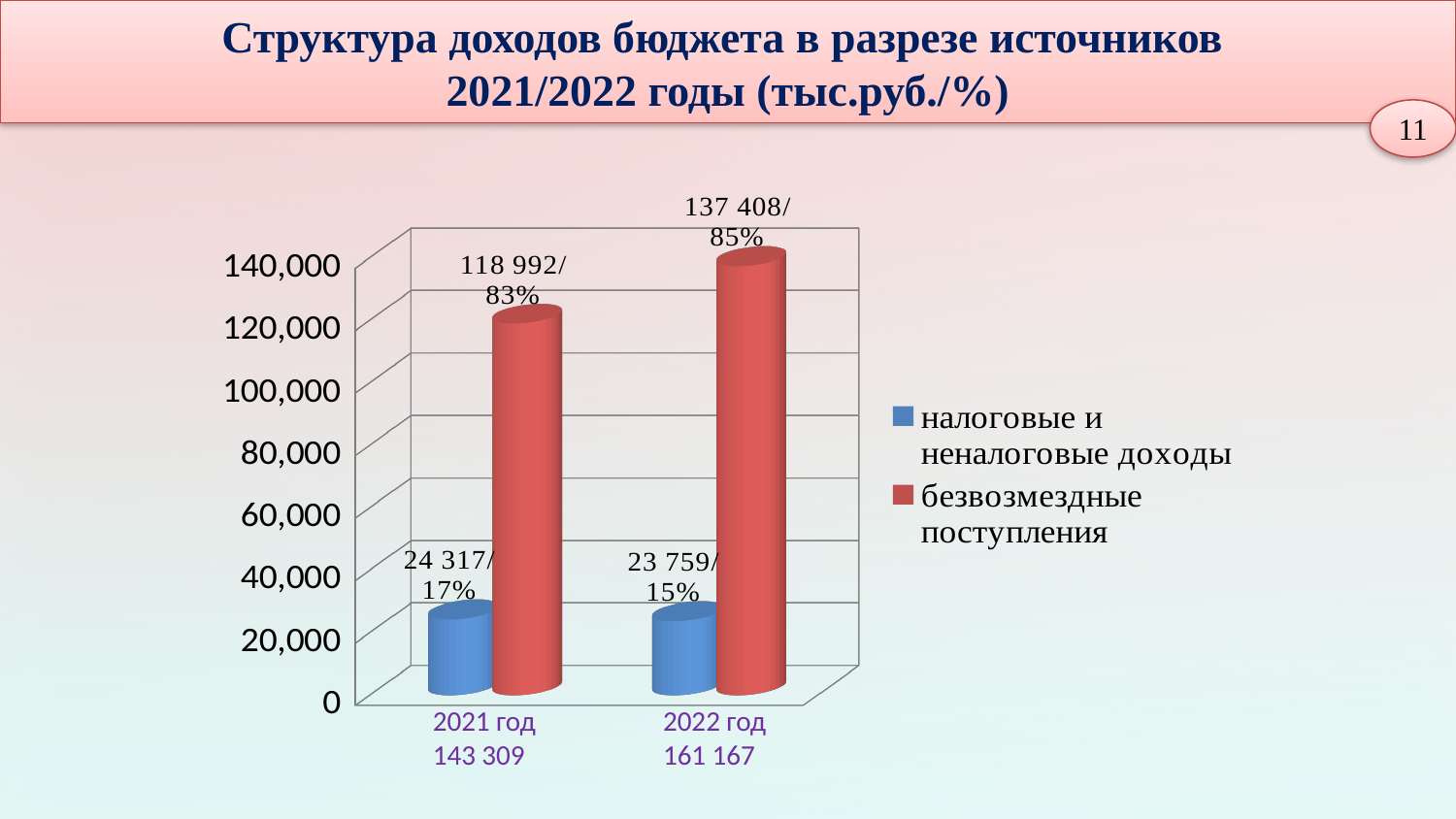
Which bar on the chart is the tallest? безвозмездные поступления, 2022 год What value is labelled on the bar for безвозмездные поступления in 2022 год? 137 408/ 85% What total is printed under the 2022 год category label? 161 167 Which is larger: безвозмездные поступления in 2021 год or in 2022 год? 2022 год What value is labelled on the bar for налоговые и неналоговые доходы in 2021 год? 24 317/ 17% Which bar on the chart is the shortest? налоговые и неналоговые доходы, 2022 год What value is labelled on the bar for налоговые и неналоговые доходы in 2022 год? 23 759/ 15% What value is labelled on the bar for безвозмездные поступления in 2021 год? 118 992/ 83% How many series does the legend list? 2 What kind of chart is shown on the slide? bar chart How many year categories are shown on the x axis? 2 Is the value for безвозмездные поступления in 2021 год greater or less than 100,000? greater